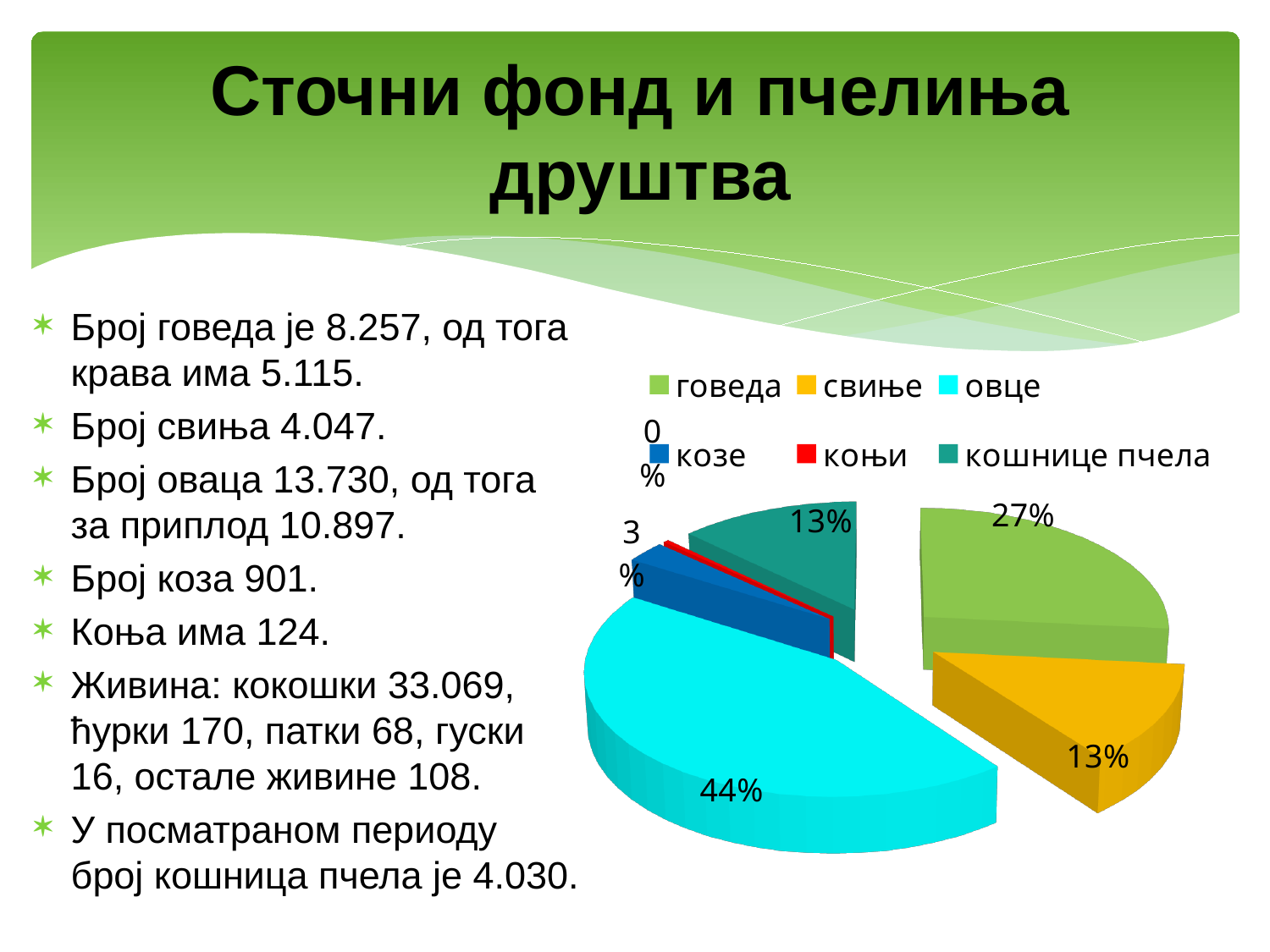
Which category has the largest slice in the pie chart? овце What is the difference in percentage points between the овце slice and the говеда slice? 17% Which slice is larger in the pie chart, говеда or свиње? говеда How many categories does the pie chart's legend list? 6 What kind of chart is shown on the slide? pie chart What share of the pie chart does овце have? 44% What colour is the овце slice in the pie chart? cyan What share of the pie chart does говеда have? 27% Which category has the smallest slice in the pie chart? коњи What share of the pie chart does свиње have? 13%